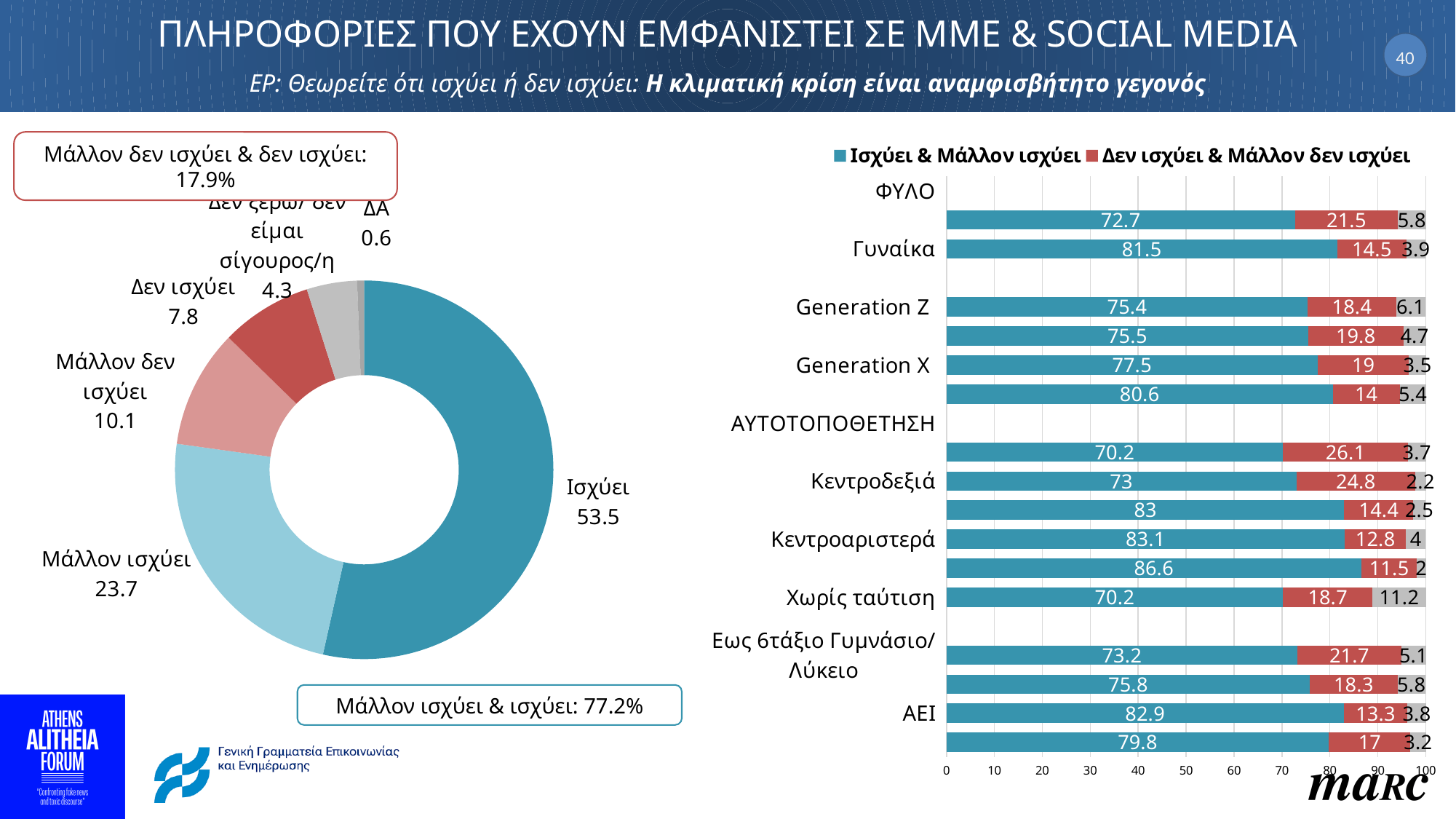
In the donut chart on the left, what is the difference between Μάλλον ισχύει and Μάλλον δεν ισχύει? 13.6 In the bar chart on the right, what is the Ισχύει & Μάλλον ισχύει value for Γυναίκα? 81.5 In the bar chart on the right, which has the higher Ισχύει & Μάλλον ισχύει value, Generation Z or Generation X? Generation X In the donut chart on the left, what is the value for Ισχύει? 53.5 How many slices does the donut chart on the left have? 6 In the bar chart on the right, what is the difference in the Ισχύει & Μάλλον ισχύει value between Κεντροαριστερά and Κεντροδεξιά? 10.1 In the donut chart on the left, which category has the largest slice? Ισχύει How many series does the legend of the bar chart on the right list? 2 What kind of chart is shown on the right of the slide? Bar chart In the bar chart on the right, what is the Δεν ισχύει & Μάλλον δεν ισχύει value for Χωρίς ταύτιση? 18.7 What kind of chart is shown on the left of the slide? Pie (donut) chart In the donut chart on the left, which category has the smallest slice? ΔΑ